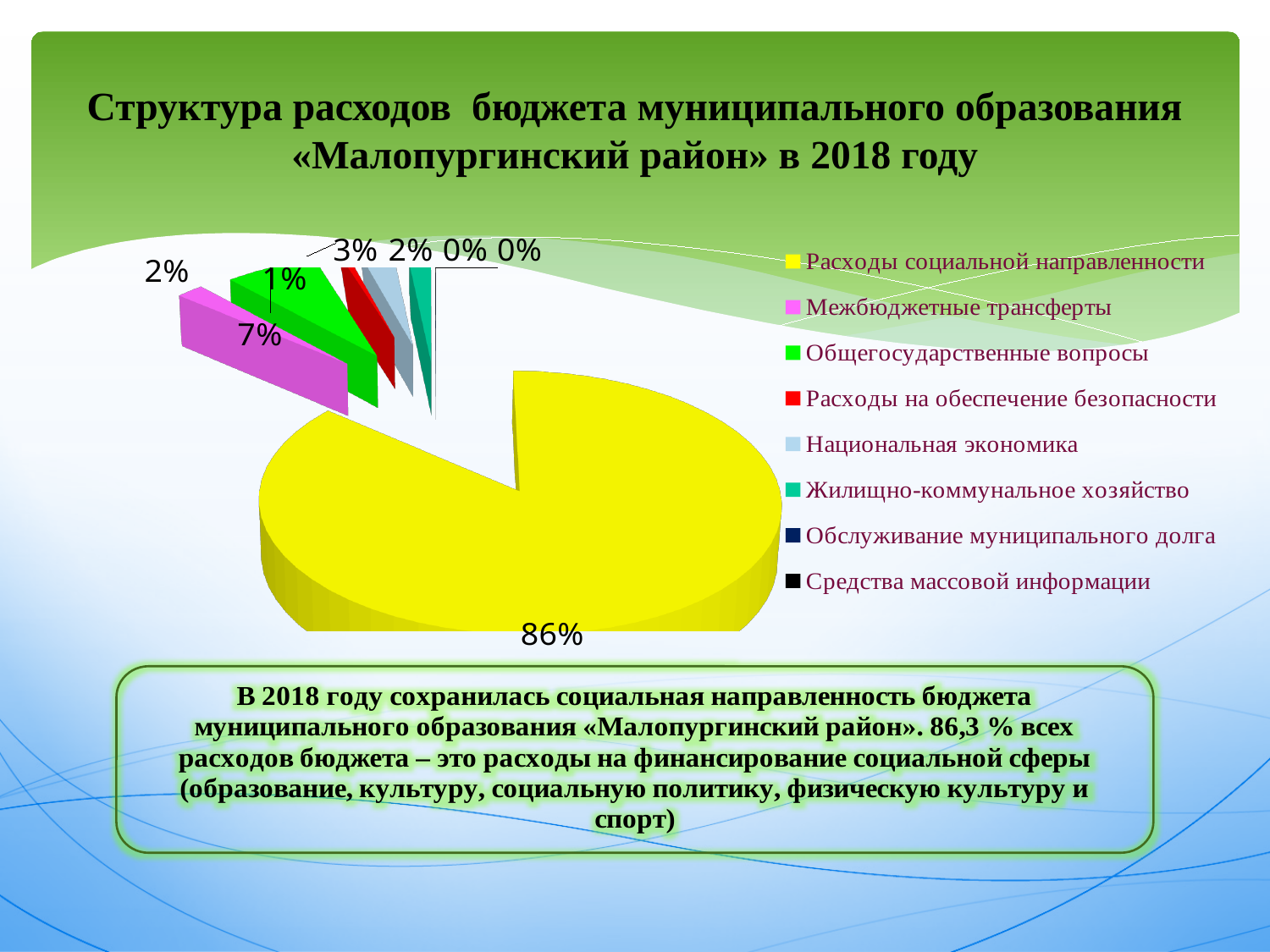
What share of the budget expenses is labelled for «Расходы социальной направленности»? 86% What share of the pie is labelled for «Межбюджетные трансферты»? 2% What colour is the slice for «Расходы социальной направленности»? yellow Which category has the largest share of the pie? Расходы социальной направленности What is the smallest share value printed on the pie chart? 0% How many categories does the legend list? 8 By how many percentage points does the share for «Расходы социальной направленности» exceed the share for «Межбюджетные трансферты»? 84 How many slices does the pie chart have? 8 Which legend entry is shown with a pink marker? Межбюджетные трансферты What kind of chart is shown on the slide? pie chart Which is larger: the share for «Расходы социальной направленности» or for «Межбюджетные трансферты»? Расходы социальной направленности